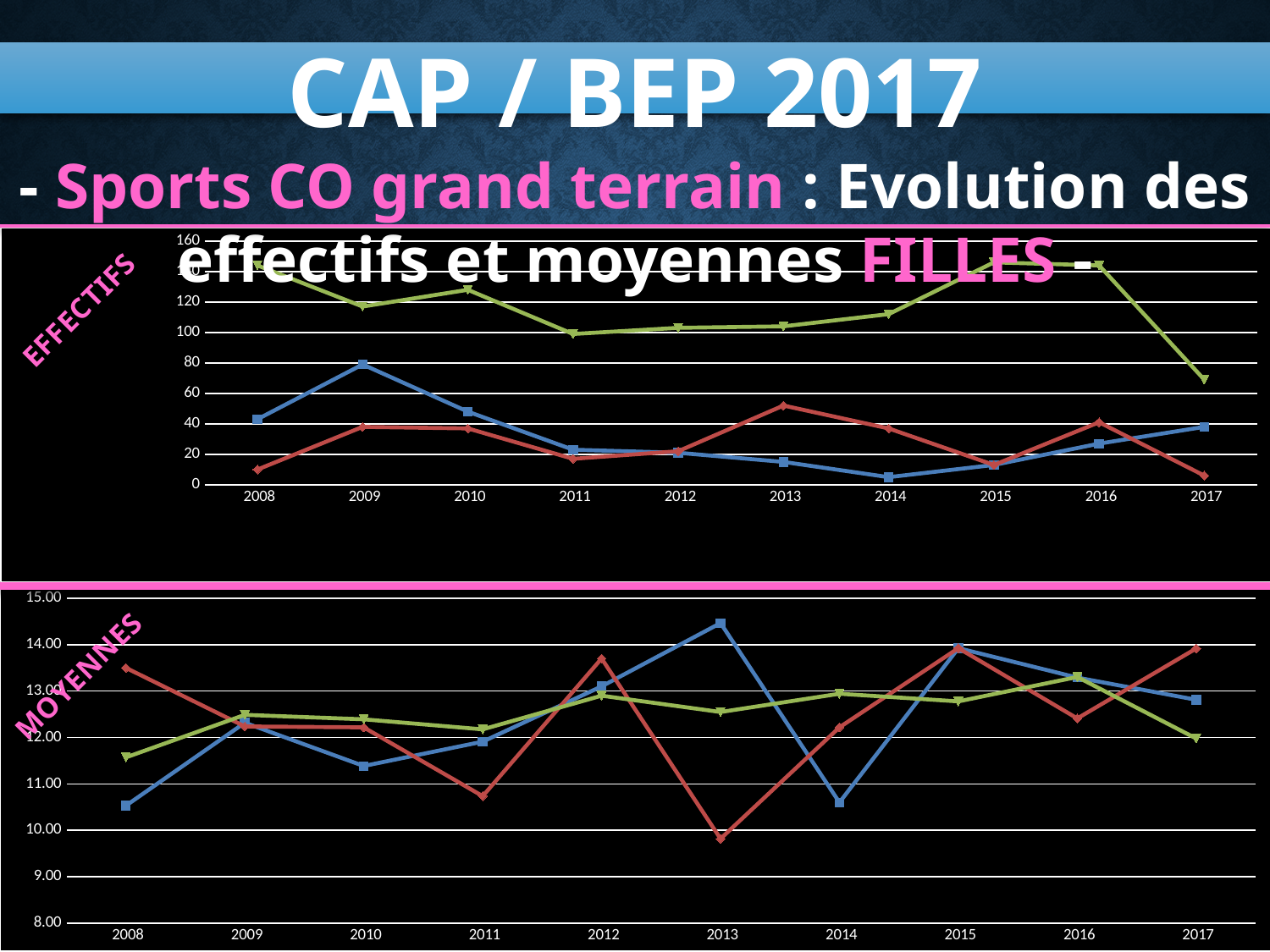
What kind of chart is the top EFFECTIFS chart? line chart In the top EFFECTIFS chart, is the value of the green line for 2017 greater or less than 80? less In the bottom MOYENNES chart, in which year does the blue line reach its highest value? 2013 In the top EFFECTIFS chart, which line is higher in 2013, the blue line or the red line? the red line In the top EFFECTIFS chart, in which year does the blue line reach its lowest value? 2014 In the top EFFECTIFS chart, in which year does the blue line reach its highest value? 2009 How many years are plotted along the x axis of the top EFFECTIFS chart? 10 In the top EFFECTIFS chart, in which year does the red line reach its highest value? 2013 In the top EFFECTIFS chart, does the green line rise or fall between 2016 and 2017? fall In the bottom MOYENNES chart, in which year does the red line reach its lowest value? 2013 In the bottom MOYENNES chart, is the value of the red line for 2013 greater or less than 10.00? less